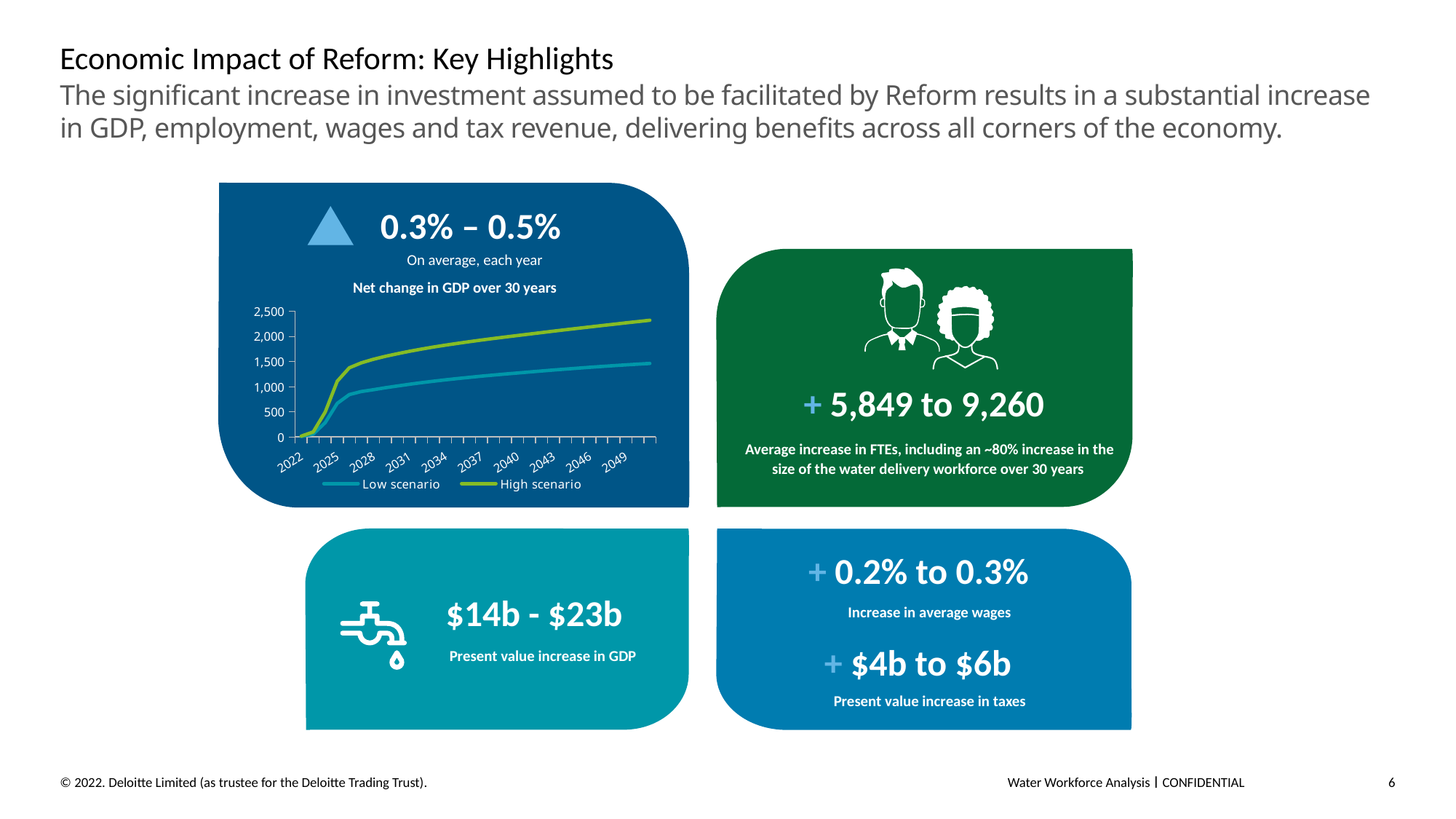
How many year labels are shown along the x axis of the chart? 10 Do the values for the High scenario rise or fall from 2022 to 2049? Rise What are the two series named in the chart's legend? Low scenario and High scenario How many series does the chart's legend list? 2 Which series reaches the higher value by 2049, Low scenario or High scenario? High scenario Is the value for the High scenario in 2049 greater or less than 2,000? greater Is the value for the High scenario in 2040 greater or less than 1,500? greater Is the value for the Low scenario in 2049 greater or less than 1,000? greater What is the title of the chart on the slide? Net change in GDP over 30 years What kind of chart is shown on the slide? Line chart